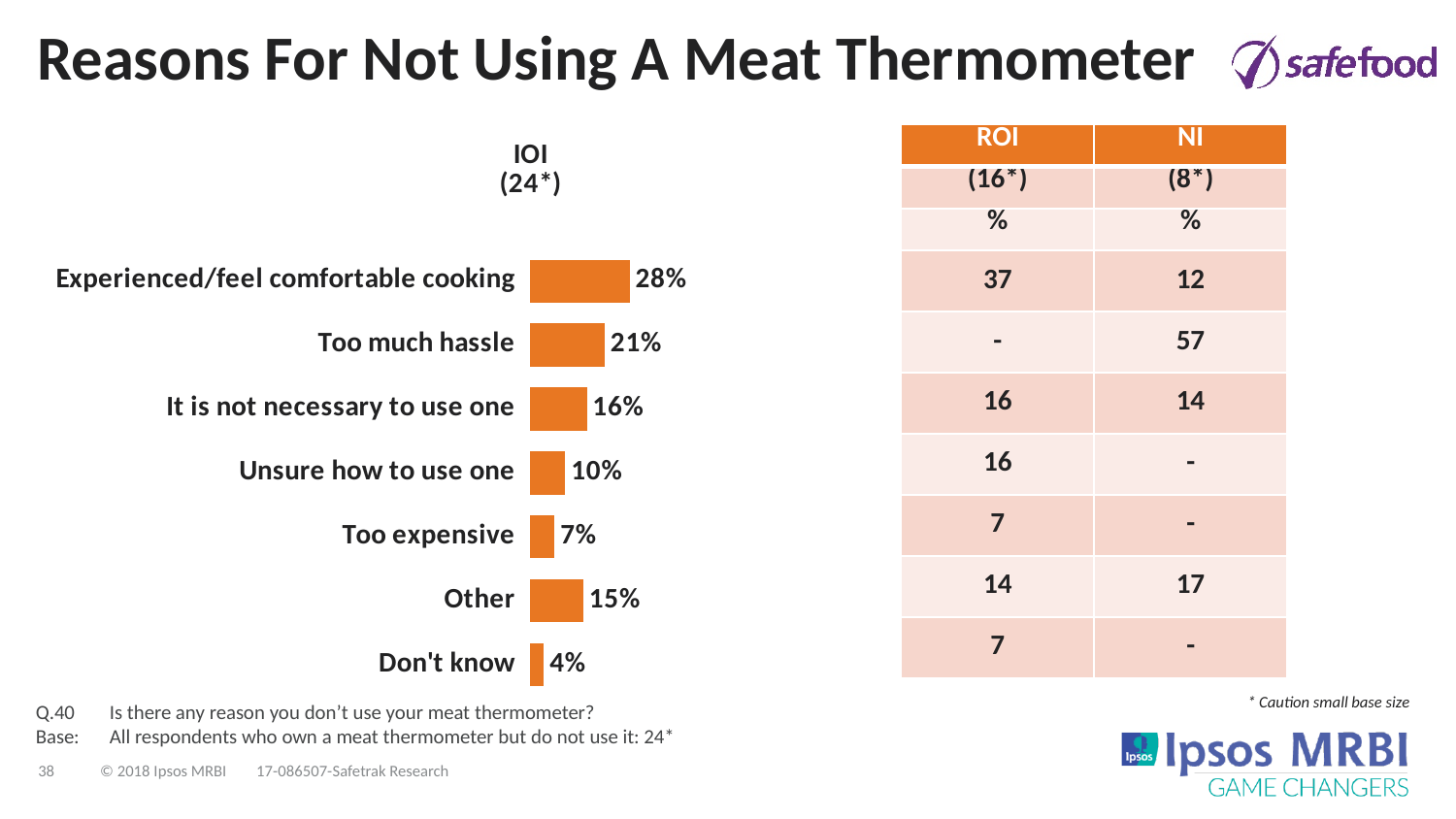
Which reason has the highest percentage in the bar chart? Experienced/feel comfortable cooking What percentage of respondents gave "Experienced/feel comfortable cooking" as a reason for not using a meat thermometer? 28% What is the value shown for "Too much hassle"? 21% What is the difference in percentage points between "It is not necessary to use one" and "Don't know"? 12 What is the value shown for "Other"? 15% What base size is shown under the IOI label above the bar chart? (24*) What is the value shown for "Unsure how to use one"? 10% What is the difference in percentage points between "Experienced/feel comfortable cooking" and "Too much hassle"? 7 What type of chart is used to show the IOI reasons for not using a meat thermometer? Bar chart Which reason has the lowest percentage in the bar chart? Don't know How many reasons (categories) are shown in the bar chart? 7 Which is larger: the value for "Too expensive" or the value for "Other"? Other